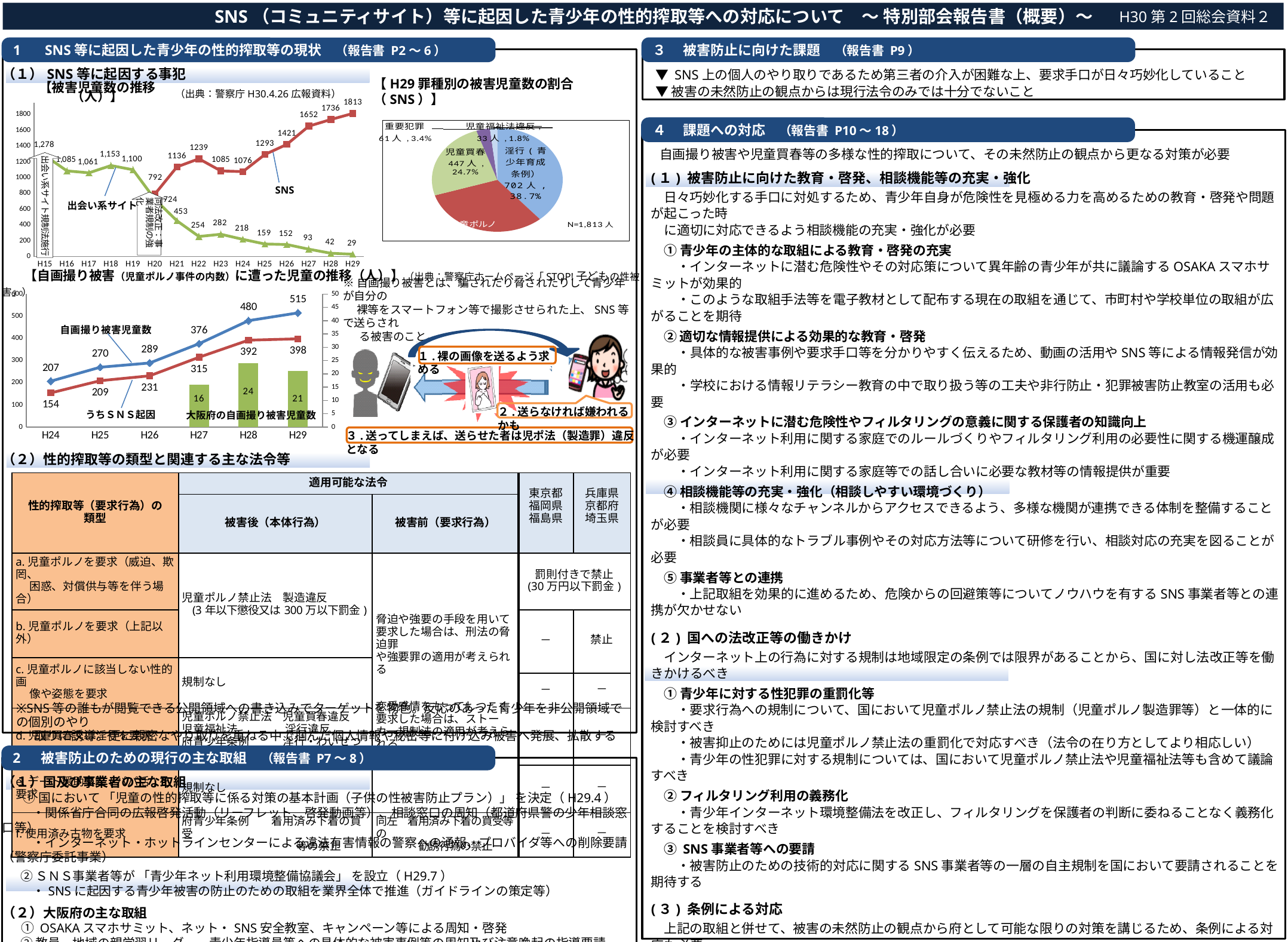
In the 自画撮り被害に遭った児童の推移 chart, how many years are shown on the x axis? 6 In the 被害児童数の推移 line chart, what is the 出会い系サイト value for H15? 1,278 In the 被害児童数の推移 line chart, what is the difference between the SNS values for H29 and H28? 77 In the 被害児童数の推移 line chart, which year has the lowest 出会い系サイト value? H29 In the 自画撮り被害に遭った児童の推移 chart, what is the 自画撮り被害児童数 value for H28? 480 In the H29 罪種別の被害児童数の割合（SNS） pie chart, which is larger, 重要犯罪 or 児童福祉法違反? 重要犯罪 In the H29 罪種別の被害児童数の割合（SNS） pie chart, how many people are in the 児童買春 slice? 447人 In the 被害児童数の推移 line chart, what is the SNS value for H29? 1813 In the 自画撮り被害に遭った児童の推移 chart, what is the うちSNS起因 value for H24? 154 In the 被害児童数の推移 line chart, does the 出会い系サイト series generally rise or fall from H15 to H29? fall In the 自画撮り被害に遭った児童の推移 chart, which year has the highest 大阪府の自画撮り被害児童数 bar? H28 In the H29 罪種別の被害児童数の割合（SNS） pie chart, what share does 淫行（青少年育成条例） have? 38.7%